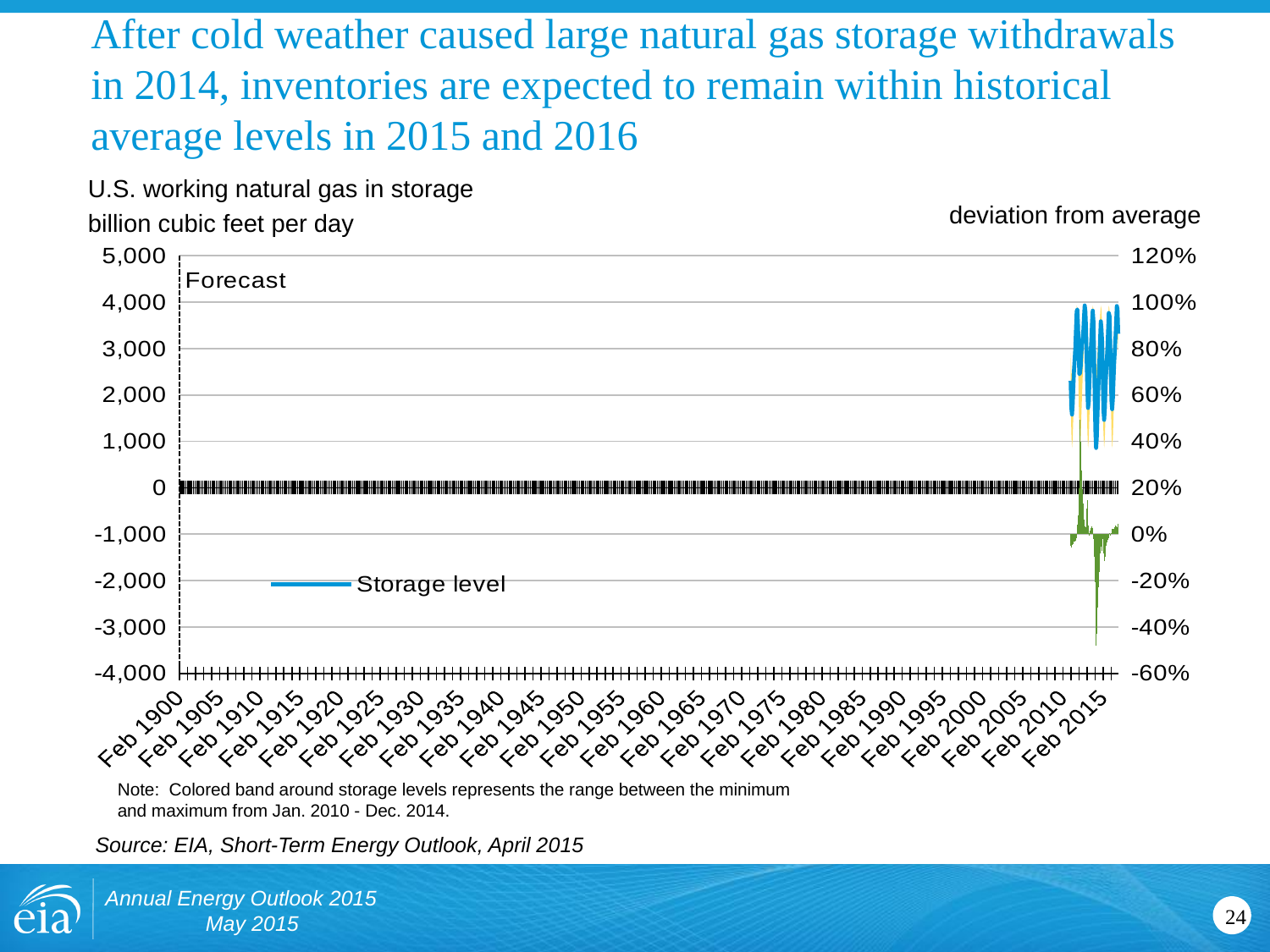
How many series does the chart legend list? 1 What is the lowest value shown on the right vertical axis? -60% What is the highest value shown on the left vertical axis? 5,000 What series name appears in the chart legend? Storage level Is the highest peak of the Storage level line greater or less than 2,000 billion cubic feet per day? greater What kind of chart is shown on the slide? combination chart (line, area band and bars)